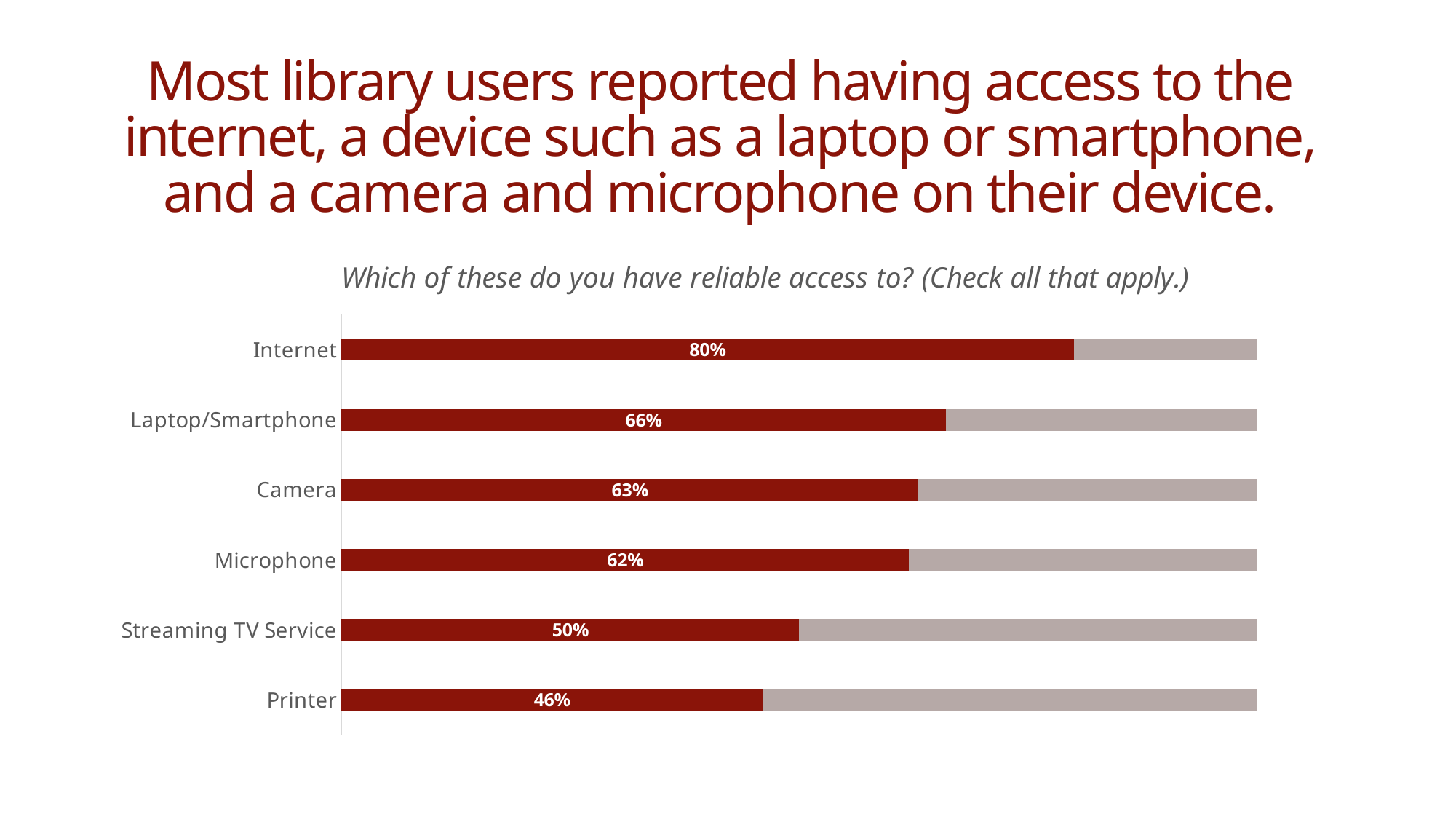
How many categories are shown in the chart? 6 Which has a higher percentage of reliable access, Laptop/Smartphone or Streaming TV Service? Laptop/Smartphone What is the difference in percentage points between Internet and Printer access? 34 Which category has the lowest percentage of users reporting reliable access? Printer What is the chart's title (the survey question shown above the bars)? Which of these do you have reliable access to? (Check all that apply.) What percentage of library users reported reliable access to the Internet? 80% What percentage of library users reported reliable access to a Laptop/Smartphone? 66% Which category has the highest percentage of users reporting reliable access? Internet What percentage of library users reported reliable access to a Streaming TV Service? 50% What percentage of library users reported reliable access to a Printer? 46% What is the difference in percentage points between Camera and Microphone access? 1 What type of chart is shown on the slide? Bar chart